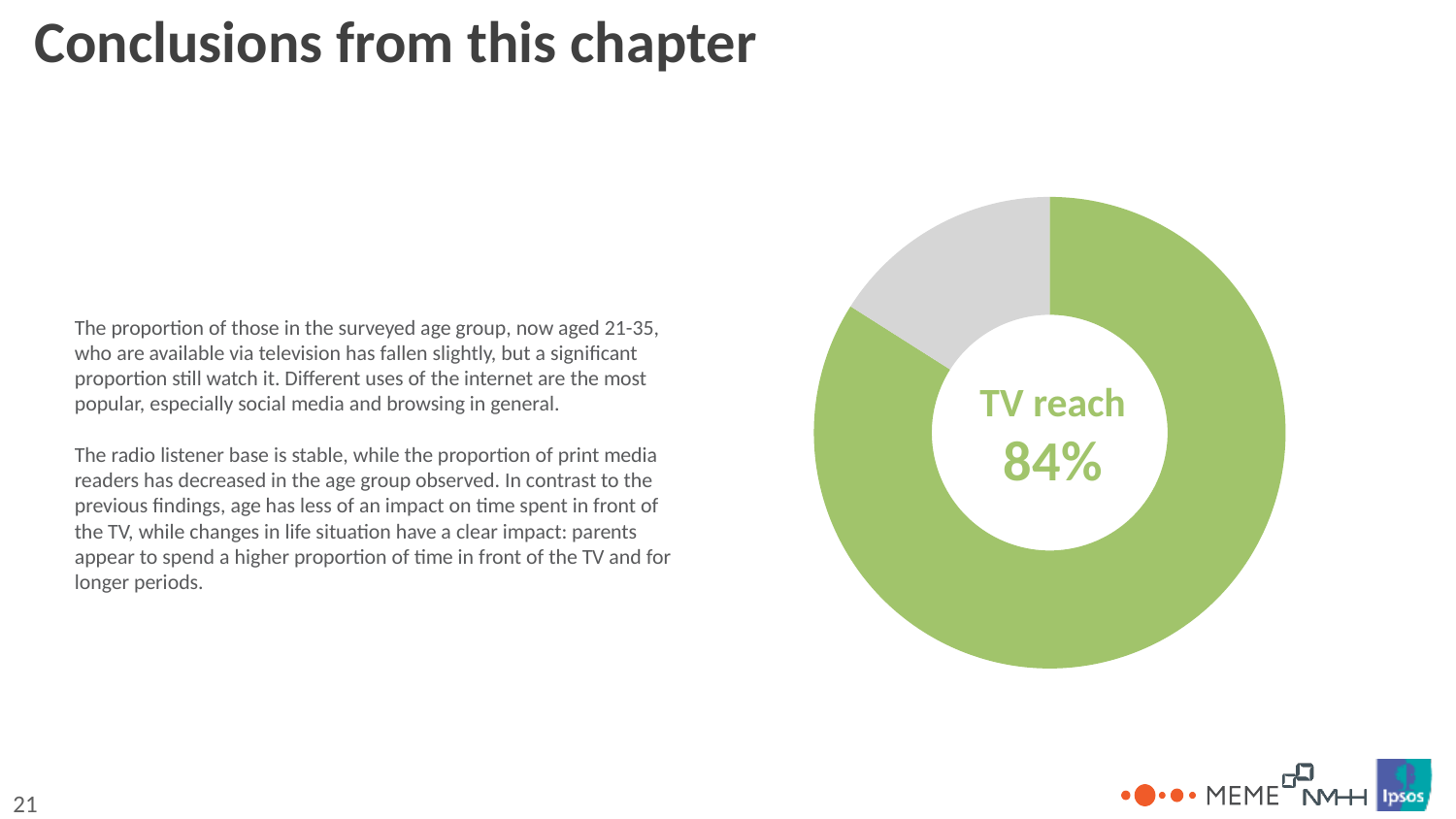
Which slice of the donut is the largest? The green (TV reach) slice What label is printed in the centre of the donut chart? TV reach 84% Which slice is larger, the green one or the grey one? The green one How many slices does the donut chart have? 2 What share of the donut does the green slice represent? 84% What kind of chart is shown on the slide? Donut (pie) chart What colour is the slice representing TV reach? Green What is the TV reach value shown in the centre of the chart? 84%